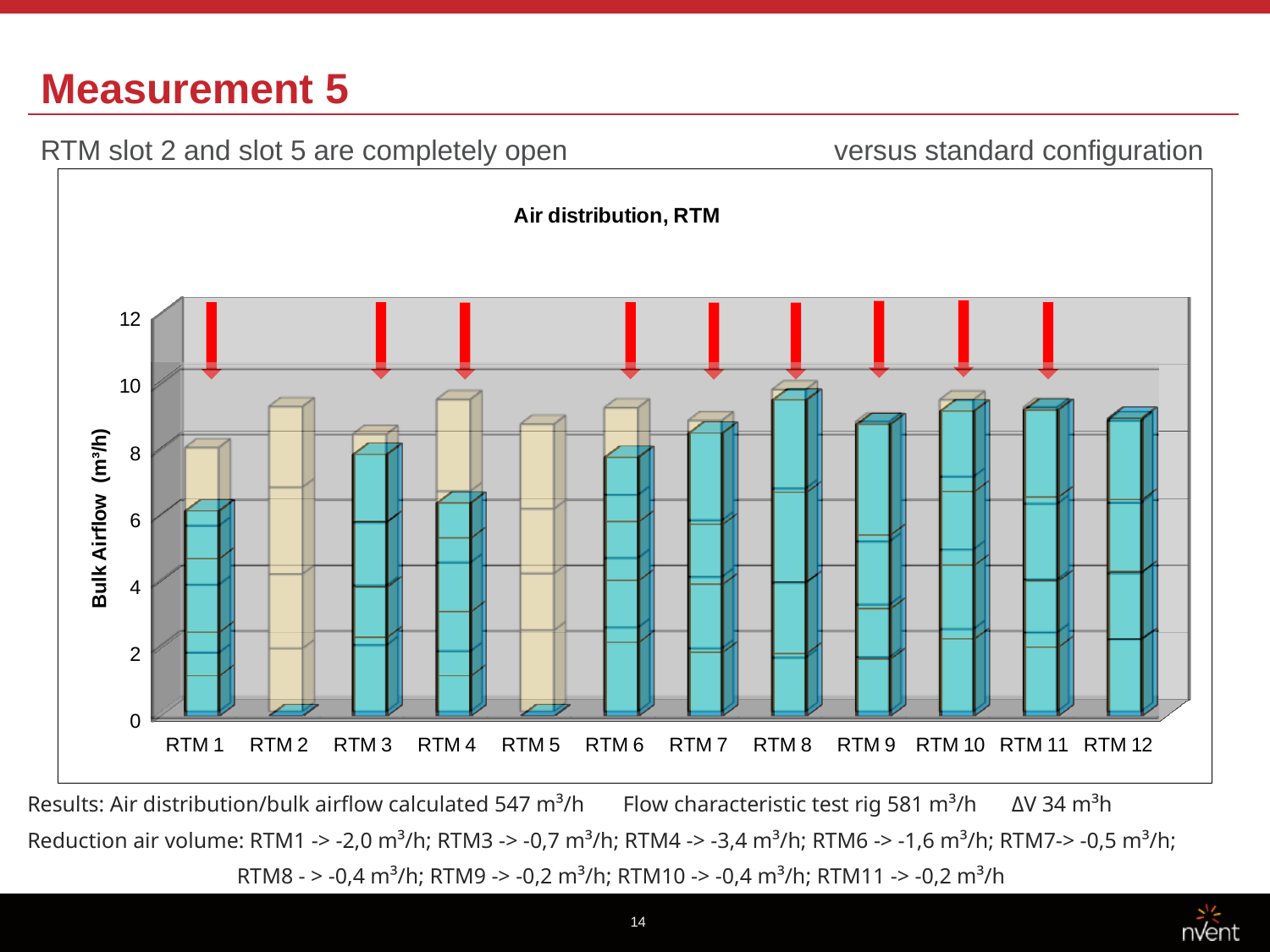
Is the blue bar for RTM 4 greater or less than 8? less Which category has the tallest blue bar? RTM 8 What type of chart is shown on the slide? bar chart Is the blue bar for RTM 2 greater or less than 2? less What is the label of the vertical axis of the chart? Bulk Airflow (m³/h) How many RTM categories are shown on the x axis of the chart? 12 What is the title of the chart? Air distribution, RTM Is the blue bar for RTM 1 greater or less than 8? less Which is larger, the blue bar for RTM 1 or the blue bar for RTM 8? RTM 8 Which is larger, the blue bar for RTM 4 or the blue bar for RTM 7? RTM 7